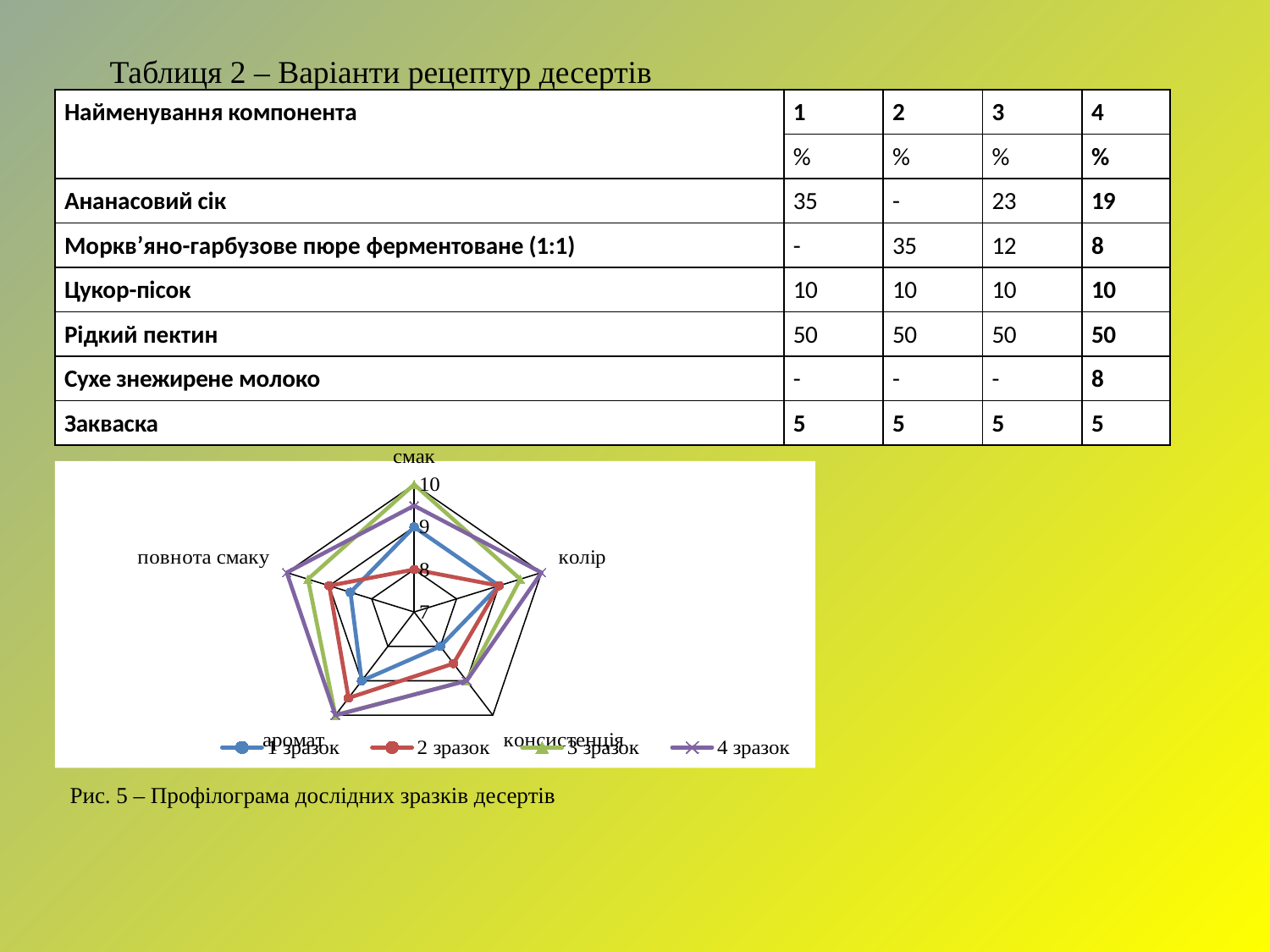
How many axes (categories) does the radar chart have? 5 For повнота смаку, which is larger: the value of 4 зразок or 1 зразок? 4 зразок What is the highest value shown on the chart's axis scale? 10 What are the legend entries of the chart? 1 зразок, 2 зразок, 3 зразок, 4 зразок How many series does the chart legend list? 4 Which series has the lowest value for смак? 2 зразок Is the value of 4 зразок for аромат greater or less than 9? greater What kind of chart is shown on the slide? radar chart Is the value of 2 зразок for смак greater or less than 9? less Is the value of 1 зразок for консистенція greater or less than 9? less Which series has the lowest value for повнота смаку? 1 зразок